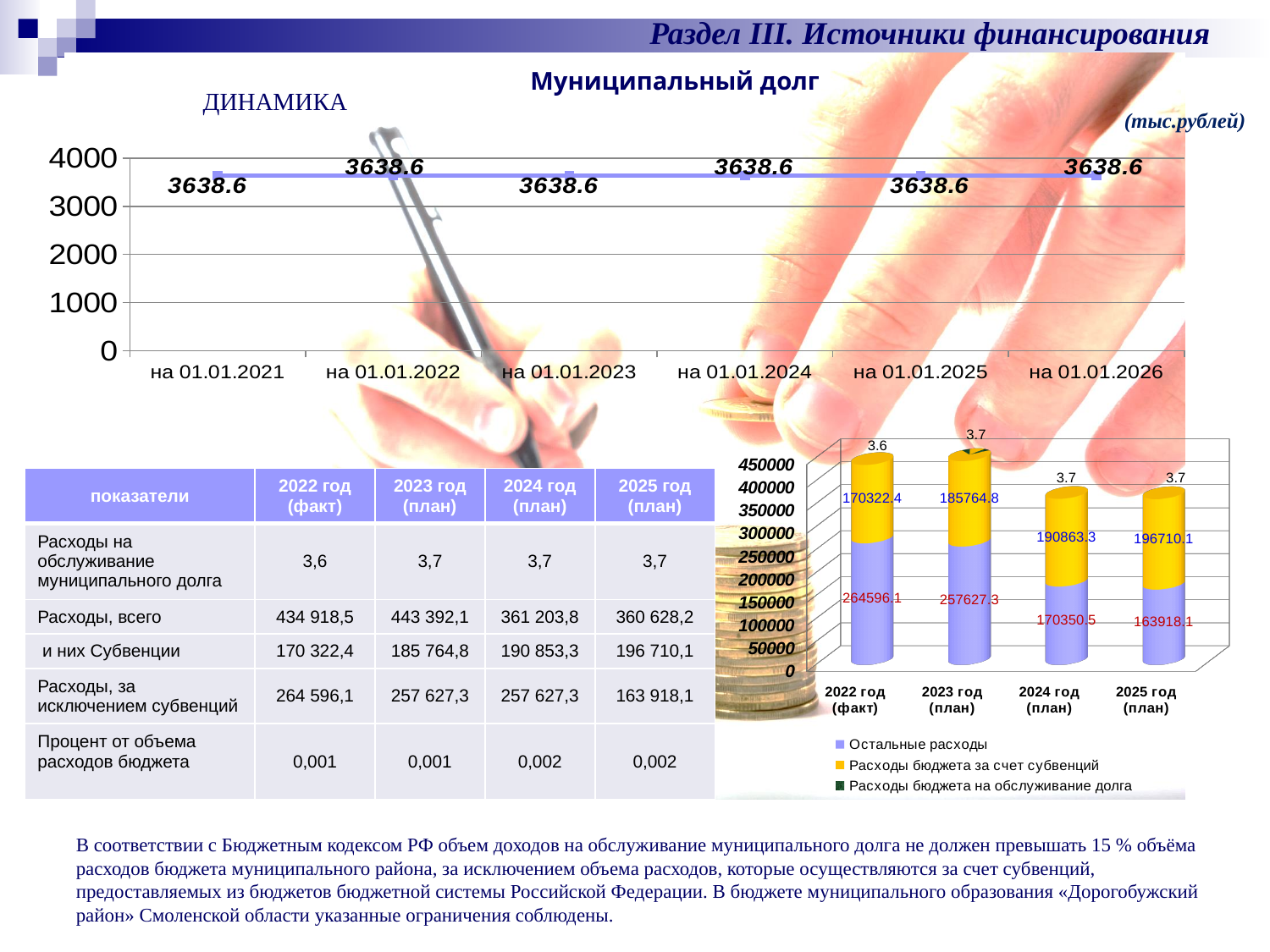
On the line chart 'Муниципальный долг', do the values rise, fall or stay the same from на 01.01.2021 to на 01.01.2026? stay the same On the stacked bar chart at the bottom right, what is the value of 'Остальные расходы' for 2022 год (факт)? 264596.1 On the line chart 'Муниципальный долг', what is the value for на 01.01.2021? 3638.6 On the stacked bar chart at the bottom right, which category has the highest value for 'Расходы бюджета за счет субвенций'? 2025 год (план) On the stacked bar chart at the bottom right, what is the value of 'Расходы бюджета за счет субвенций' for 2025 год (план)? 196710.1 How many series does the legend of the stacked bar chart at the bottom right list? 3 On the stacked bar chart at the bottom right, which is larger for 'Остальные расходы': 2023 год (план) or 2024 год (план)? 2023 год (план) On the stacked bar chart at the bottom right, what is the difference between 'Остальные расходы' for 2022 год (факт) and 2025 год (план)? 100678.0 On the line chart 'Муниципальный долг', is the value for на 01.01.2024 greater or less than 3000? greater On the line chart 'Муниципальный долг', how many data points are plotted? 6 What kind of chart is the 'Муниципальный долг' chart at the top of the slide? line chart On the stacked bar chart at the bottom right, what is the value of 'Расходы бюджета на обслуживание долга' for 2022 год (факт)? 3.6